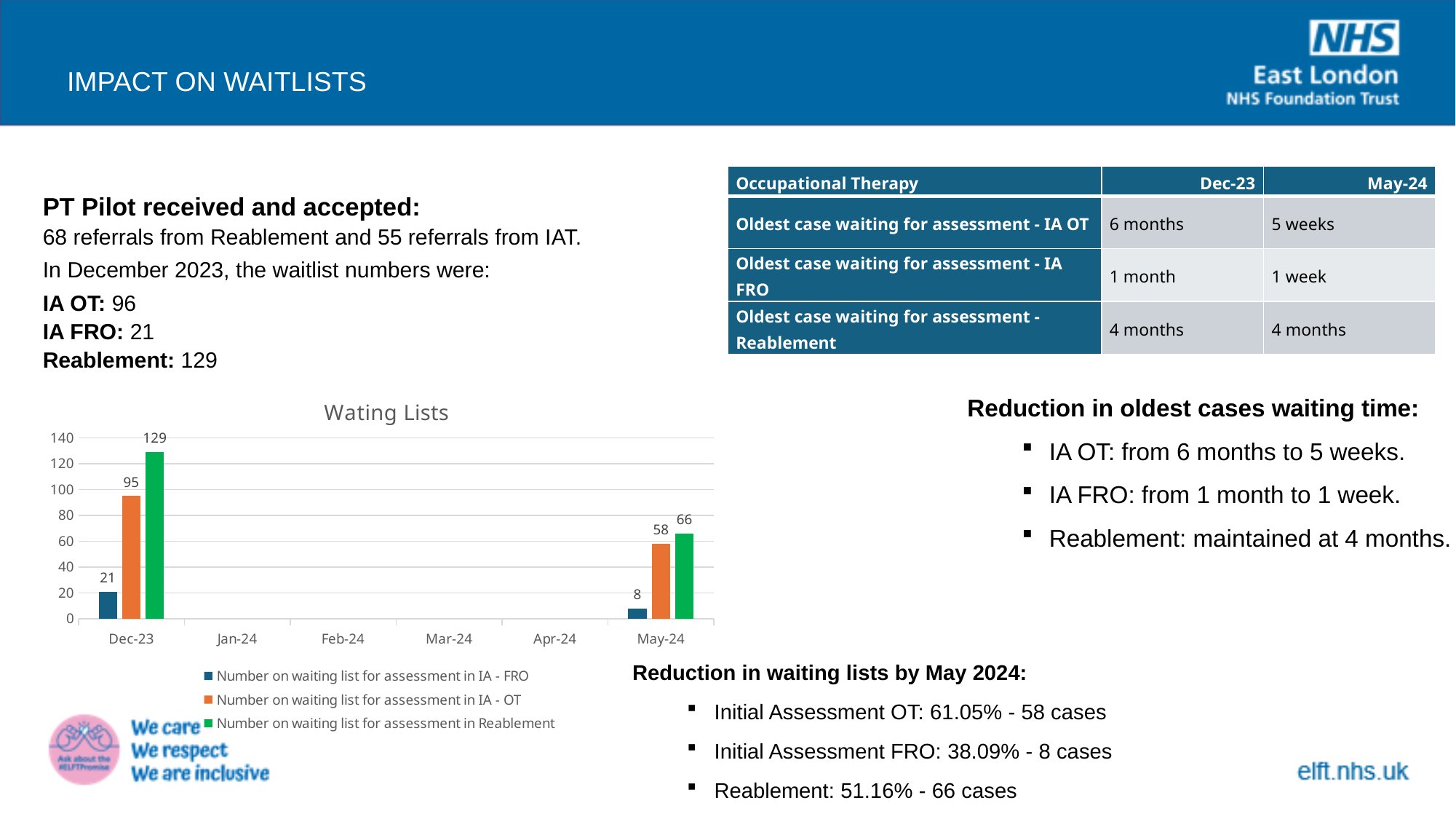
In the "Wating Lists" chart, what is the number on the waiting list for assessment in IA - FRO in Dec-23? 21 How many month labels are shown on the x axis of the "Wating Lists" chart? 6 In the "Wating Lists" chart, which series has the lowest value in May-24? Number on waiting list for assessment in IA - FRO In the "Wating Lists" chart, what is the number on the waiting list for assessment in IA - OT in May-24? 58 In the "Wating Lists" chart, what is the number on the waiting list for assessment in Reablement in Dec-23? 129 In the "Wating Lists" chart, is the IA - OT value in Dec-23 larger or smaller than the IA - OT value in May-24? larger What type of chart is shown under the title "Wating Lists"? bar chart How many series does the legend of the "Wating Lists" chart list? 3 In the "Wating Lists" chart, which series has the highest value in Dec-23? Number on waiting list for assessment in Reablement In the "Wating Lists" chart, what is the difference between the IA - OT value and the IA - FRO value in Dec-23? 74 In the "Wating Lists" chart, do the values for each series rise or fall from Dec-23 to May-24? fall In the "Wating Lists" chart, what is the difference between the Reablement values for Dec-23 and May-24? 63